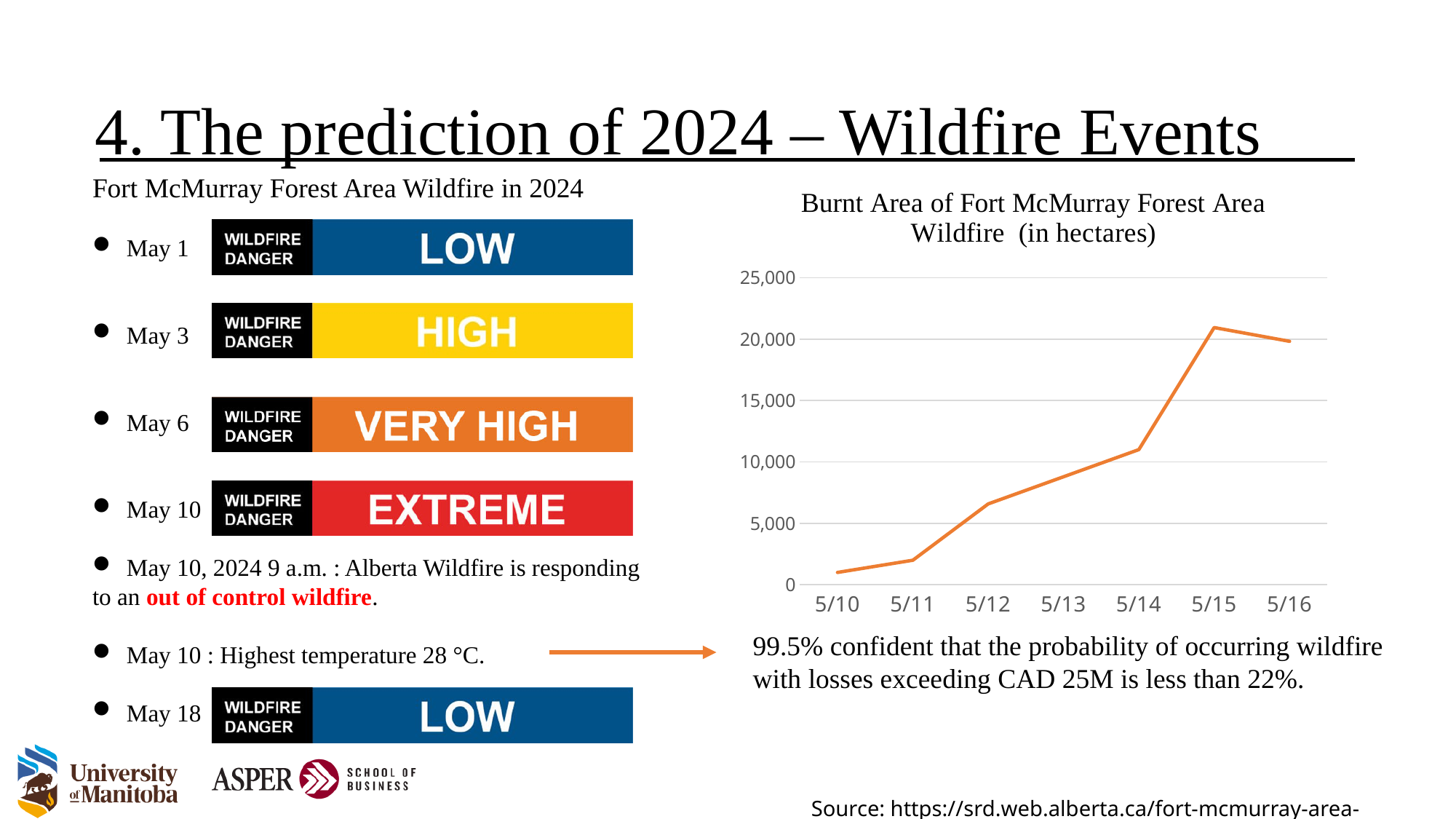
Is the burnt area on 5/16 greater or less than 15,000 hectares? greater Does the burnt area generally rise or fall from 5/10 to 5/15? rise What colour is the line in the chart? orange Is the burnt area on 5/14 greater or less than 15,000 hectares? less What is the title of the chart on the slide? Burnt Area of Fort McMurray Forest Area Wildfire (in hectares) What kind of chart is shown on the slide? line chart Which date has a larger burnt area, 5/12 or 5/14? 5/14 Is the burnt area on 5/11 greater or less than 5,000 hectares? less On which date is the burnt area lowest? 5/10 How many dates are plotted on the x axis of the chart? 7 On which date is the burnt area highest? 5/15